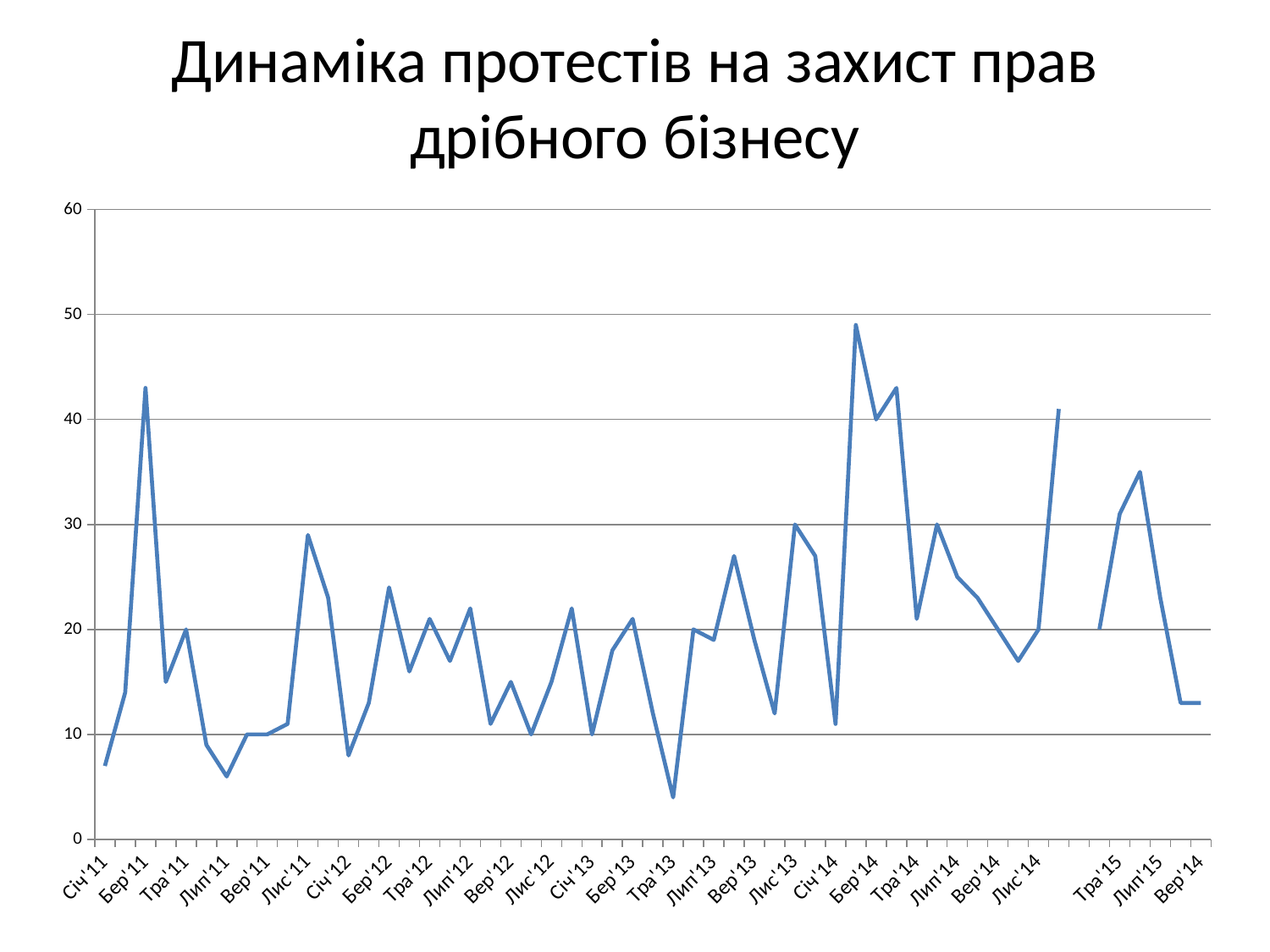
What type of chart is shown on the slide? line chart Which labelled month has the lowest value on the chart? Тра'13 What is the maximum value shown on the vertical axis? 60 Is the value for Бер'11 greater or less than 40? greater Which is larger, the value for Бер'11 or the value for Лип'11? Бер'11 Is the value for Лип'11 greater or less than 10? less Which is larger, the value for Лис'11 or the value for Січ'12? Лис'11 Is the value for Лис'11 greater or less than 20? greater What is the title of the chart? Динаміка протестів на захист прав дрібного бізнесу